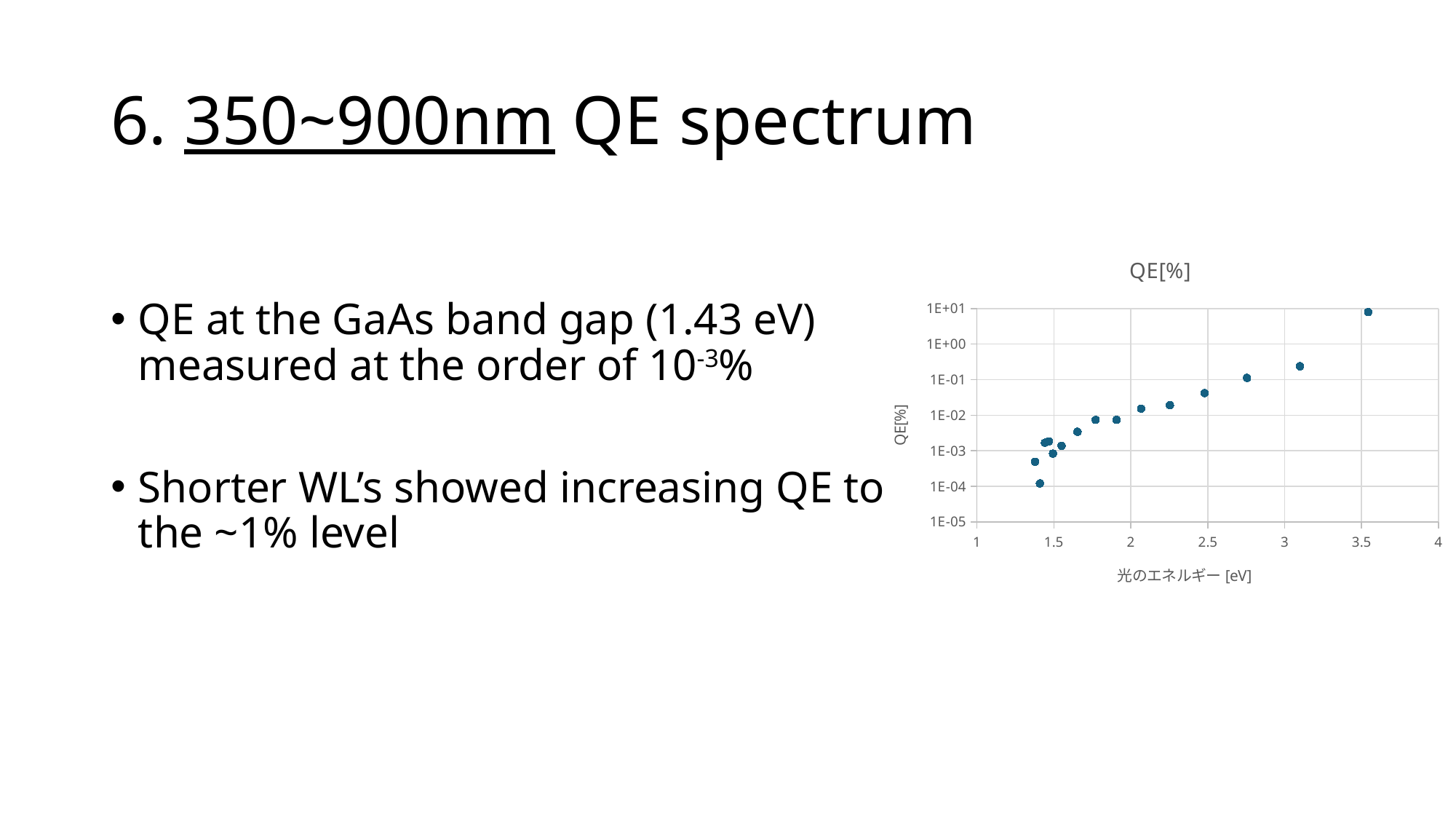
What kind of chart is shown on the slide? scatter chart Do the QE values generally rise or fall as the photon energy increases along the x axis? rise Is the QE value of the point at about 3.1 eV greater or less than 1E+00? less What is the label of the x axis of the chart? 光のエネルギー [eV] Is the QE value of the point at about 3.5 eV greater or less than 1E+00? greater What is the title of the chart? QE[%] Is the lowest QE value plotted greater or less than 1E-03? less What is the highest tick value shown on the y axis? 1E+01 Which point has the highest QE value: the one at about 3.5 eV or the one at about 3.1 eV? the one at about 3.5 eV